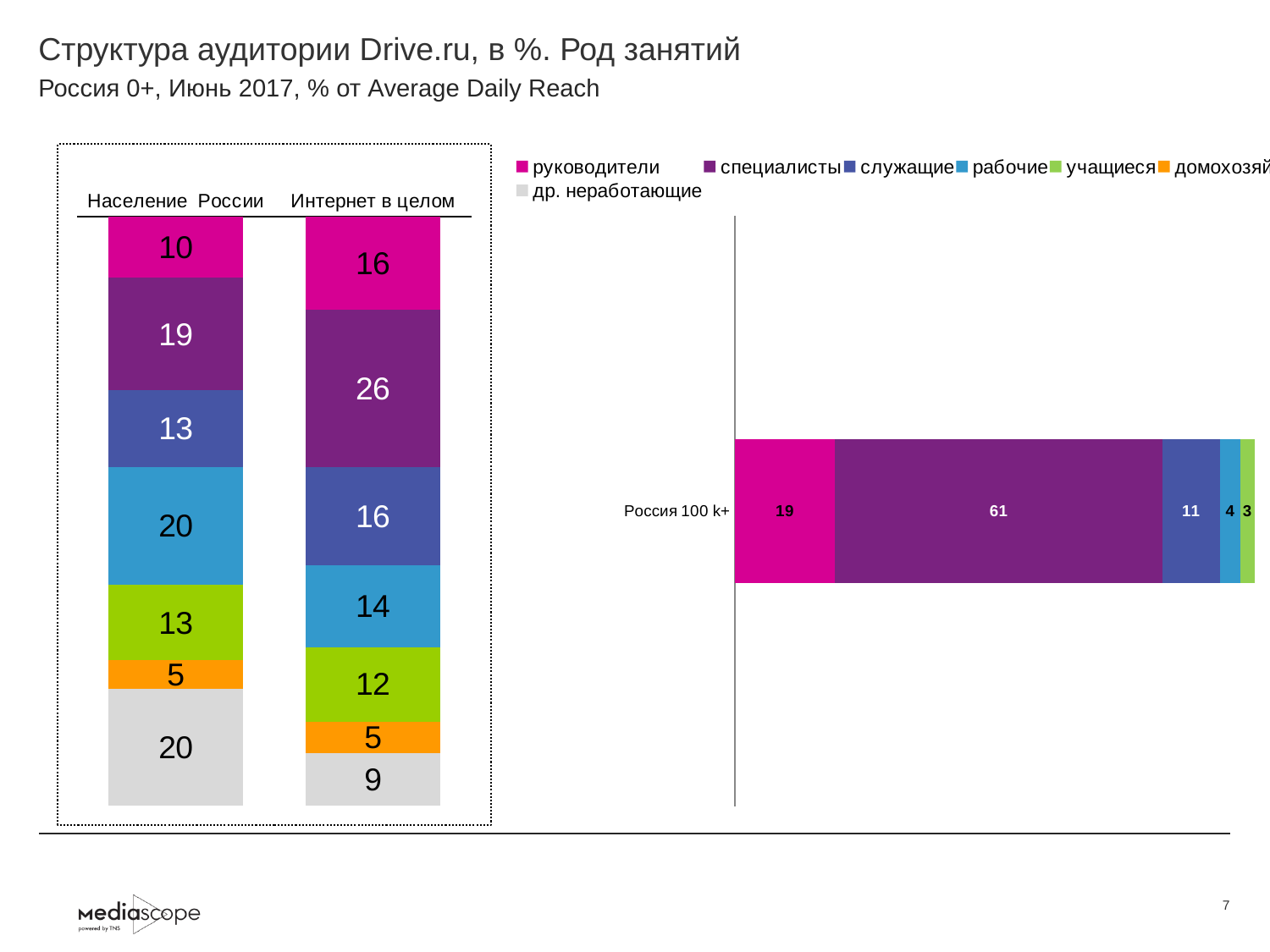
In the left chart, which segment is the largest in the Интернет в целом bar? специалисты In the right chart, what is the value for специалисты for Россия 100 k+? 61 In the left chart, which segment is the smallest in the Население России bar? домохозяйки In the left chart, what is the difference between the руководители values for Интернет в целом and Население России? 6 How many series does the legend list? 7 In the left chart, what is the value for специалисты in the Интернет в целом bar? 26 In the left chart, what is the value for рабочие in the Население России bar? 20 In the right chart, what is the value for руководители for Россия 100 k+? 19 In the left chart, how many bars are shown? 2 In the left chart, which is larger: др. неработающие for Население России or for Интернет в целом? Население России In the right chart, what is the total of the labelled segments for Россия 100 k+? 98 What kind of chart is the right chart? stacked bar chart